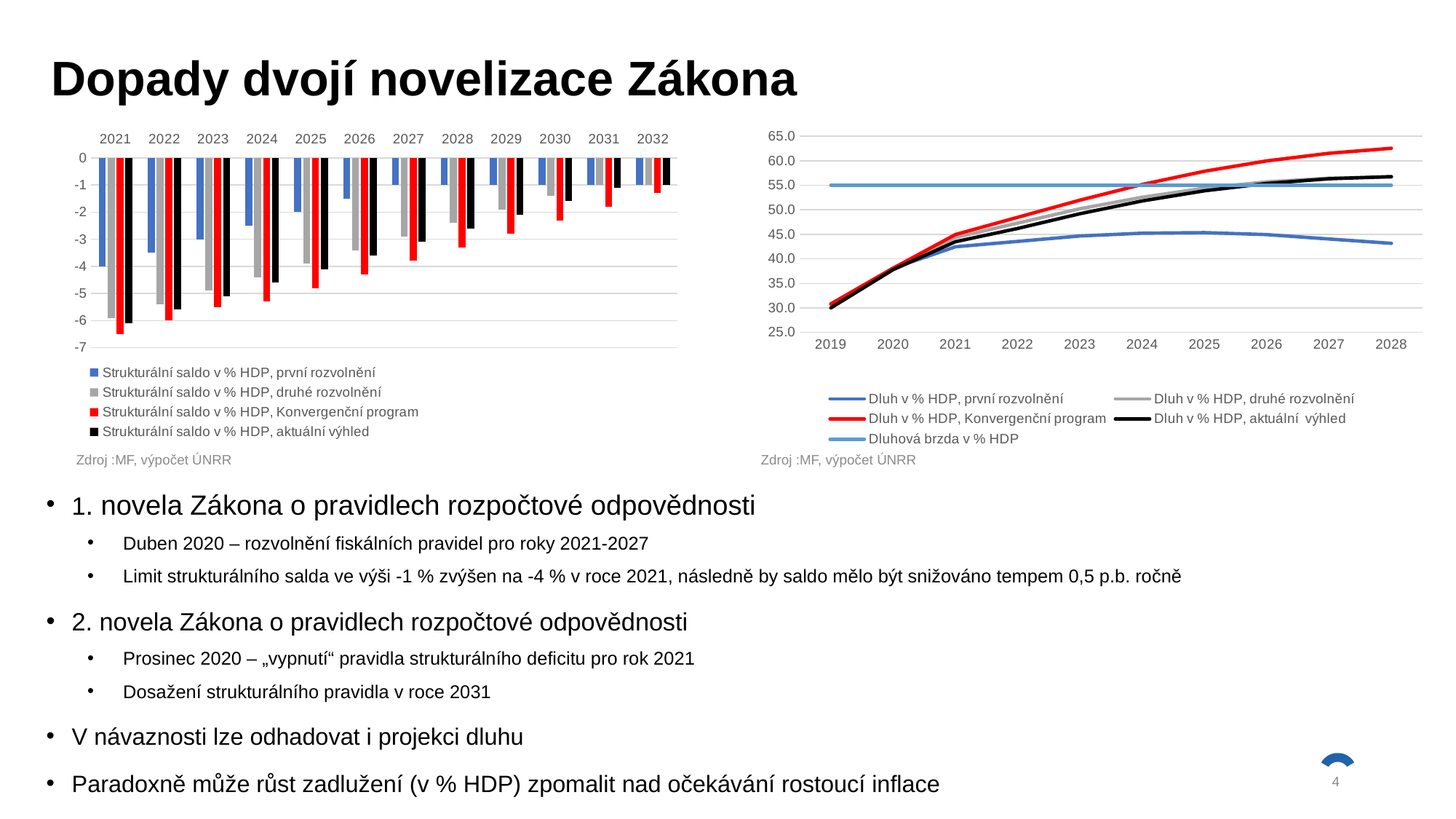
What kind of chart is the left chart (Strukturální saldo v % HDP)? bar chart In the left chart, is the value for Strukturální saldo v % HDP, první rozvolnění in 2021 greater or less than -3? less In the right chart, is the value for Dluh v % HDP, Konvergenční program in 2028 greater or less than 60.0? greater What kind of chart is the right chart (Dluh v % HDP)? line chart In the right chart, what is the value of Dluhová brzda v % HDP in 2019? 55.0 How many series does the legend of the left chart list? 4 In the right chart, does the line for Dluh v % HDP, Konvergenční program rise or fall from 2019 to 2028? rise In the left chart, which is lower in 2021: Strukturální saldo v % HDP, Konvergenční program or Strukturální saldo v % HDP, první rozvolnění? Strukturální saldo v % HDP, Konvergenční program How many years are shown on the x axis of the right chart? 10 How many years are shown on the x axis of the left chart? 12 In the right chart, which series has the highest value in 2028? Dluh v % HDP, Konvergenční program How many series does the legend of the right chart list? 5